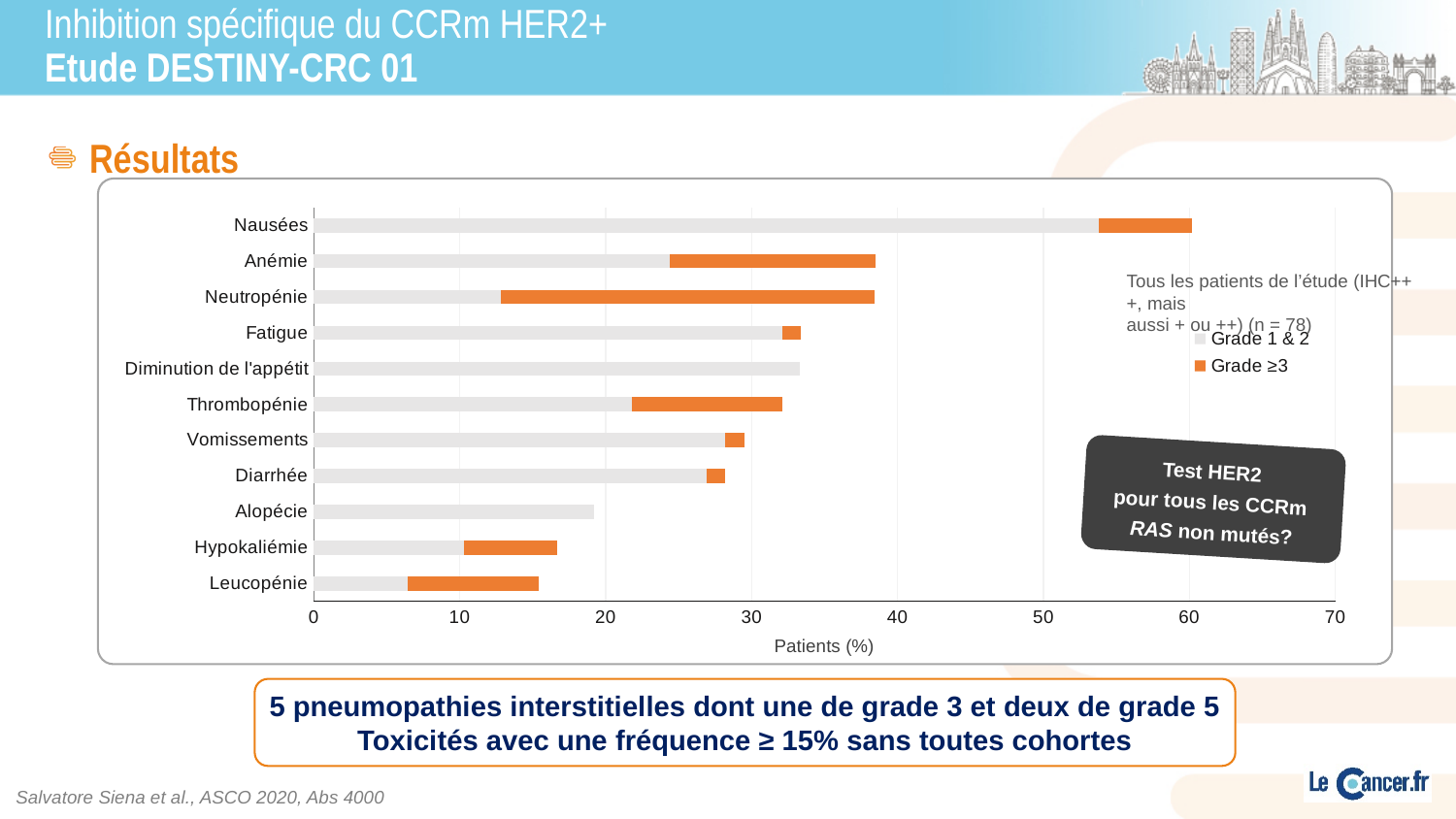
Which has a larger total value, Nausées or Anémie? Nausées What kind of chart is shown on the slide? Bar chart Which adverse event has the highest total percentage of patients? Nausées Which has a larger total value, Thrombopénie or Diarrhée? Thrombopénie How many series does the chart legend list? 2 How many adverse event categories are listed on the chart? 11 Is the total value for Hypokaliémie greater or less than 20? less Is the total value for Alopécie greater or less than 10? greater Is the total value for Anémie greater or less than 30? greater Which adverse event has the largest Grade ≥3 segment? Neutropénie What is the label of the x axis? Patients (%)